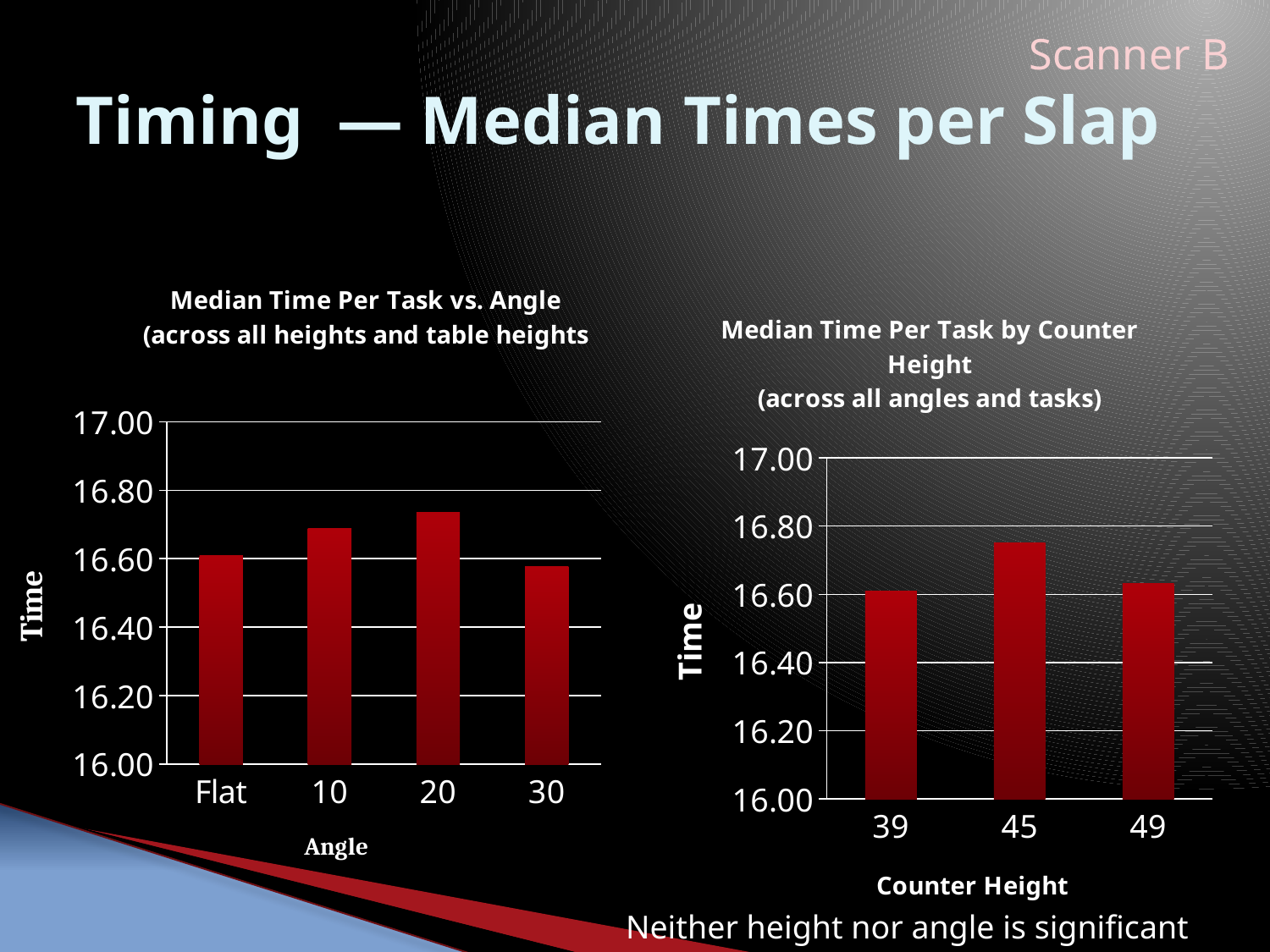
How many counter height categories are shown on the right chart, 'Median Time Per Task by Counter Height'? 3 On the right chart, 'Median Time Per Task by Counter Height', which is larger, the value for 45 or the value for 49? 45 On the right chart, 'Median Time Per Task by Counter Height', is the value for 45 greater or less than 16.60? greater What is the x-axis label on the left chart, 'Median Time Per Task vs. Angle'? Angle What is the x-axis label on the right chart, 'Median Time Per Task by Counter Height'? Counter Height On the left chart, 'Median Time Per Task vs. Angle', is the value for 30 greater or less than 16.80? less On the left chart, 'Median Time Per Task vs. Angle', is the value for 20 greater or less than 16.60? greater On the left chart, 'Median Time Per Task vs. Angle', which angle has the highest median time? 20 On the right chart, 'Median Time Per Task by Counter Height', which counter height has the highest median time? 45 How many angle categories are shown on the left chart, 'Median Time Per Task vs. Angle'? 4 What kind of chart is the 'Median Time Per Task vs. Angle' chart on the left? bar chart On the left chart, 'Median Time Per Task vs. Angle', which is larger, the value for 20 or the value for Flat? 20